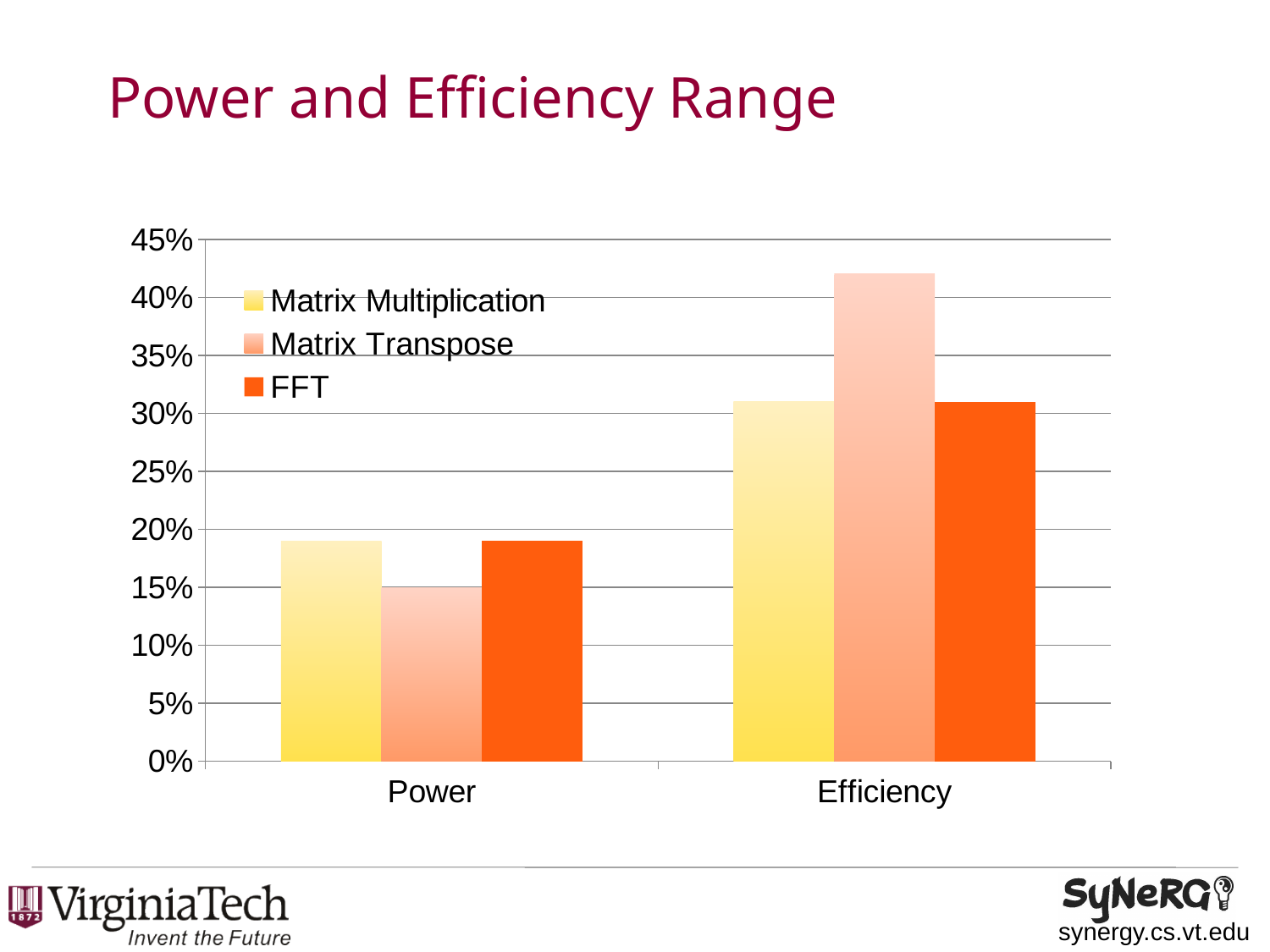
Which series has the lowest value in the Power category? Matrix Transpose Is the value for Matrix Multiplication in the Efficiency category greater or less than 35%? less Is the value for Matrix Transpose in the Efficiency category greater or less than 40%? greater Is the value for FFT in the Efficiency category greater or less than 25%? greater What kind of chart is shown on the slide? bar chart In the Power category, which is larger: FFT or Matrix Transpose? FFT How many series does the legend list? 3 In the Efficiency category, which is larger: Matrix Transpose or Matrix Multiplication? Matrix Transpose How many categories are shown on the x axis? 2 What is the title of the slide containing the chart? Power and Efficiency Range Which series has the highest value in the Efficiency category? Matrix Transpose